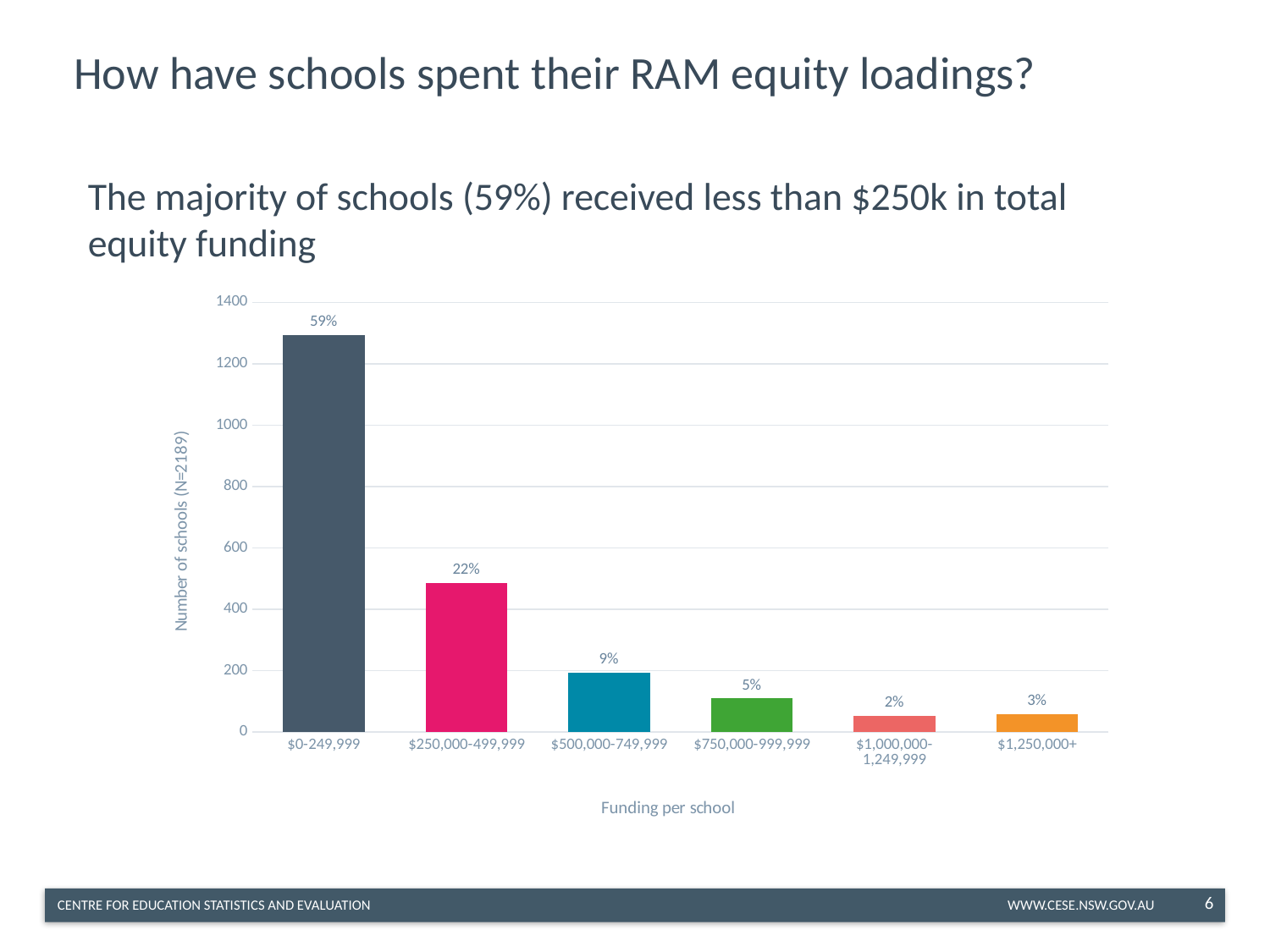
What percentage label is shown on the bar for $500,000-749,999? 9% Is the number of schools for $0-249,999 greater or less than 1200? greater What is the difference in percentage points between the $0-249,999 bar and the $250,000-499,999 bar? 37 percentage points What percentage label is shown on the bar for $0-249,999? 59% Which funding category has the highest number of schools? $0-249,999 What kind of chart is shown on the slide? Bar chart What percentage label is shown on the bar for $250,000-499,999? 22% Which has the larger share of schools: $1,250,000+ or $1,000,000-1,249,999? $1,250,000+ Which funding category has the lowest number of schools? $1,000,000-1,249,999 How many funding categories are shown on the x axis? 6 Is the number of schools for $250,000-499,999 greater or less than 600? less What percentage label is shown on the bar for $1,250,000+? 3%